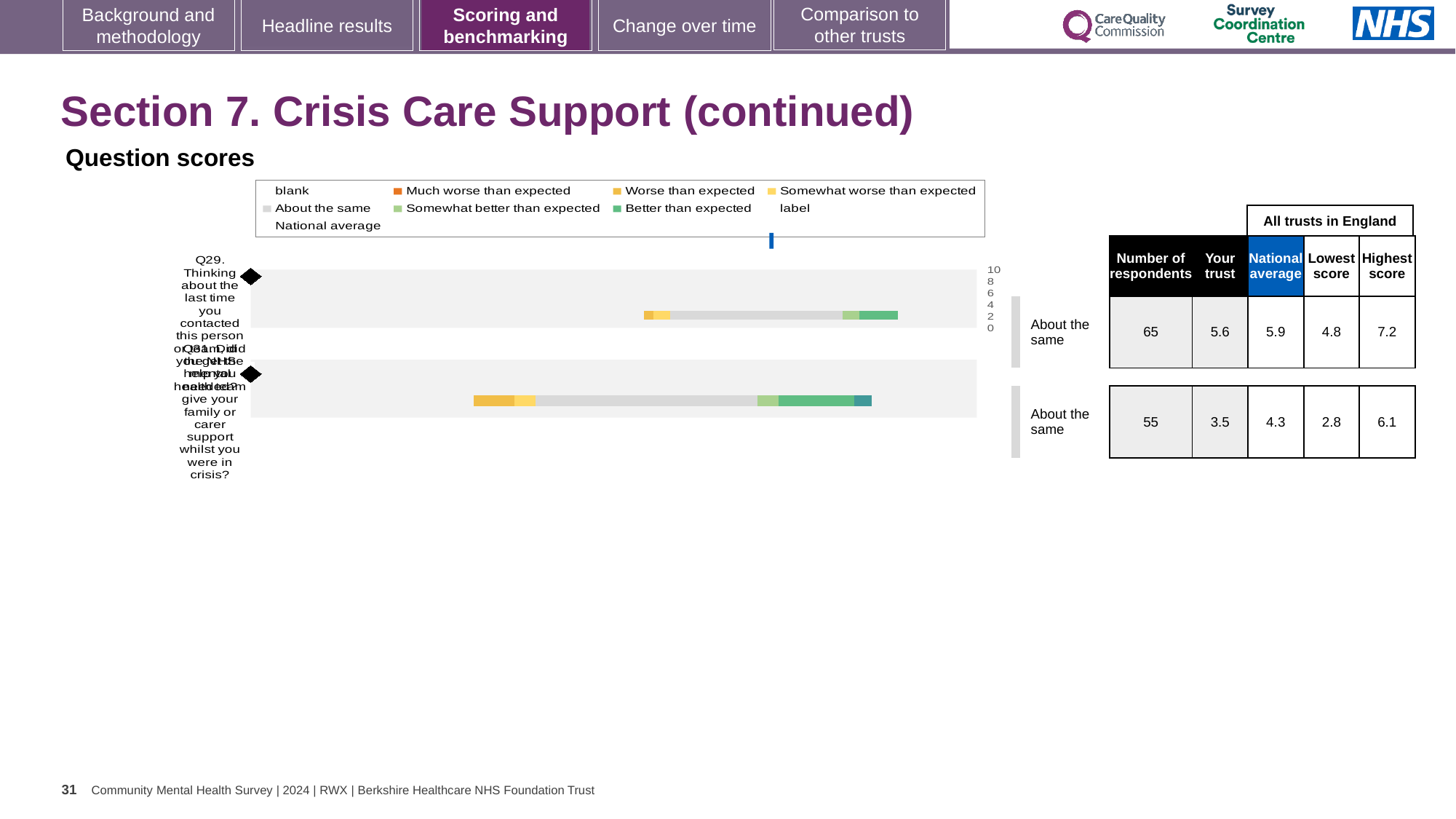
How many questions (bars) are plotted in the Question scores chart? 2 What kind of chart is shown under 'Question scores'? bar chart What is the 'Your trust' score for Q29 in the Question scores chart? 5.6 What is the national average for Q31 in the Question scores chart? 4.3 What is the lowest score across all trusts in England for Q31? 2.8 Which question has the higher 'Your trust' score, Q29 or Q31? Q29 What colour represents 'Much worse than expected' in the chart legend? Orange What is the difference between the highest score and the lowest score for Q29? 2.4 How many respondents answered Q29? 65 By how much does the national average exceed the trust's score for Q31? 0.8 For Q29, which is larger: the trust's score or the national average? National average What is the maximum value shown on the chart's score axis? 10